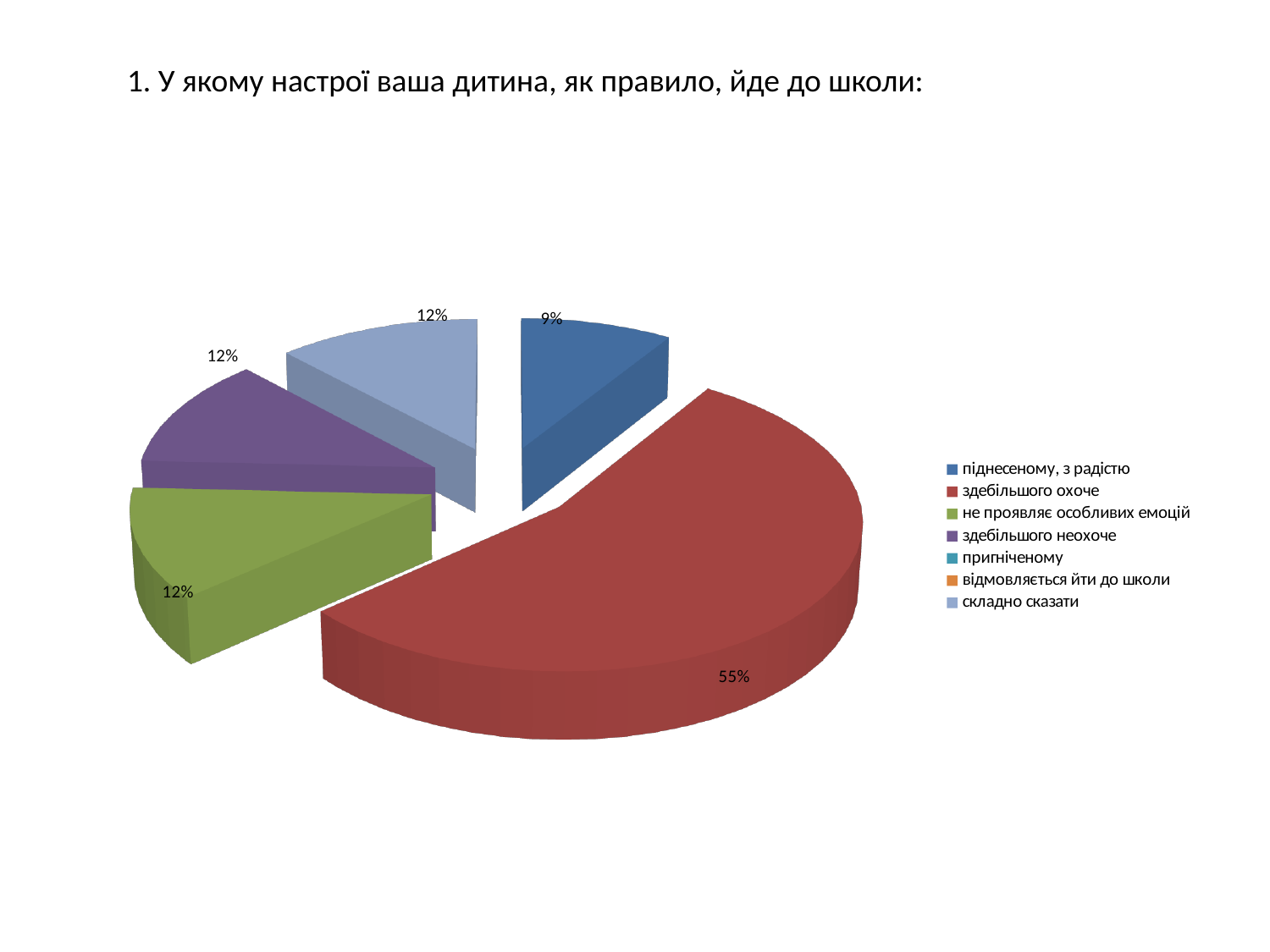
Which category has the largest slice of the pie? здебільшого охоче What percentage is shown for the slice "здебільшого охоче"? 55% What is the difference in percentage points between "здебільшого охоче" and "не проявляє особливих емоцій"? 43 What percentage is shown for the slice "піднесеному, з радістю"? 9% What percentage is shown for the slice "складно сказати"? 12% How many entries does the legend list? 7 Among the slices with a printed percentage, which category has the smallest share? піднесеному, з радістю Which is larger: the slice for "здебільшого охоче" or the slice for "піднесеному, з радістю"? здебільшого охоче What is the title of the slide above the chart? 1. У якому настрої ваша дитина, як правило, йде до школи: What percentage is shown for the slice "здебільшого неохоче"? 12% How many slices have a percentage label printed on the chart? 5 What kind of chart is shown on the slide? pie chart